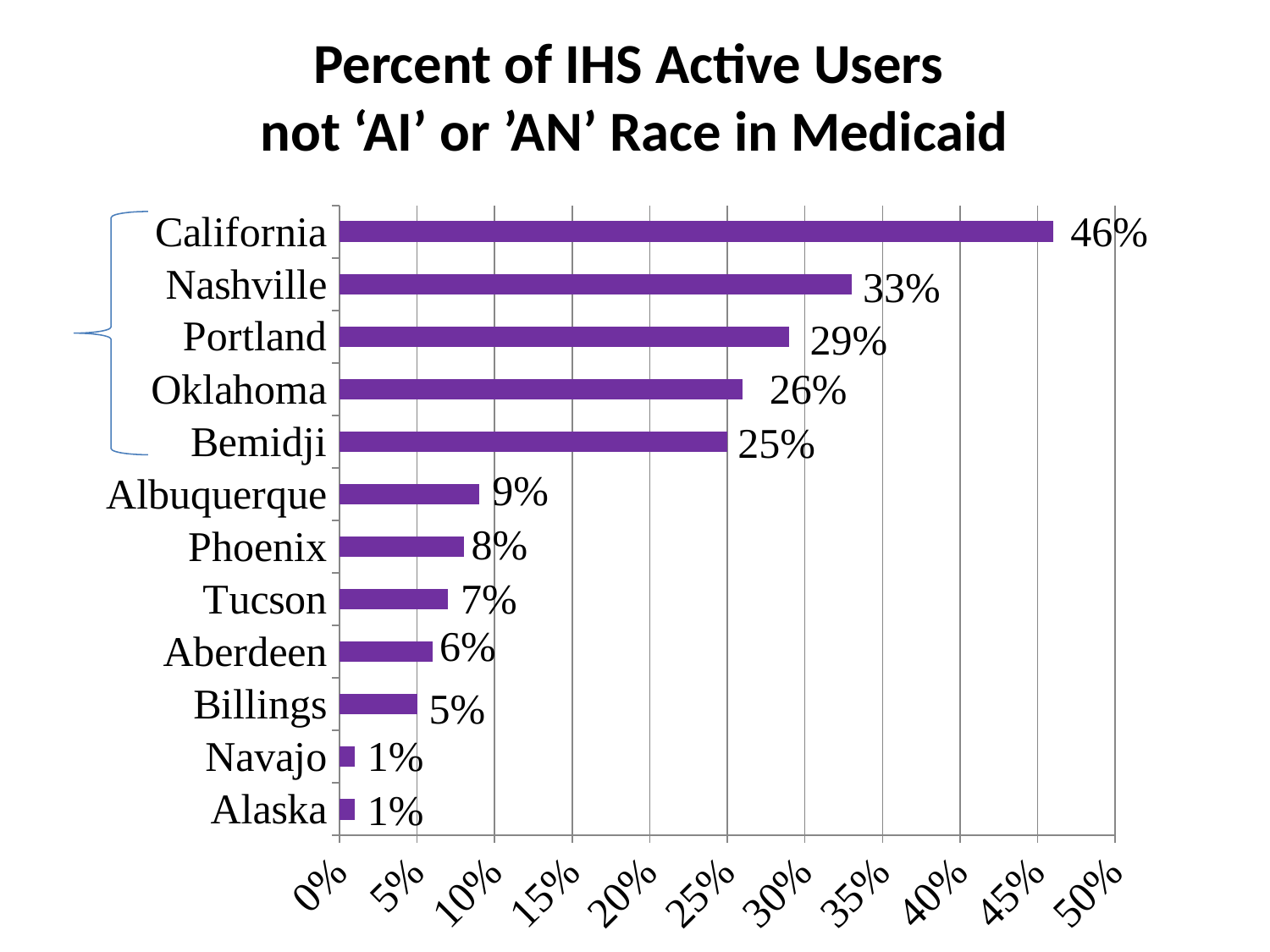
What is the title of the chart? Percent of IHS Active Users not 'AI' or 'AN' Race in Medicaid What colour are the bars in the chart? purple What is the value for Bemidji? 25% What is the difference between the values for Nashville and Portland? 4% Which category has the highest value? California What is the difference between the values for California and Albuquerque? 37% How many categories are shown in the chart? 12 What is the value for California? 46% Which is larger, the value for Oklahoma or the value for Phoenix? Oklahoma What kind of chart is shown on the slide? bar chart Is the value for Portland greater or less than 20%? greater What is the value for Billings? 5%